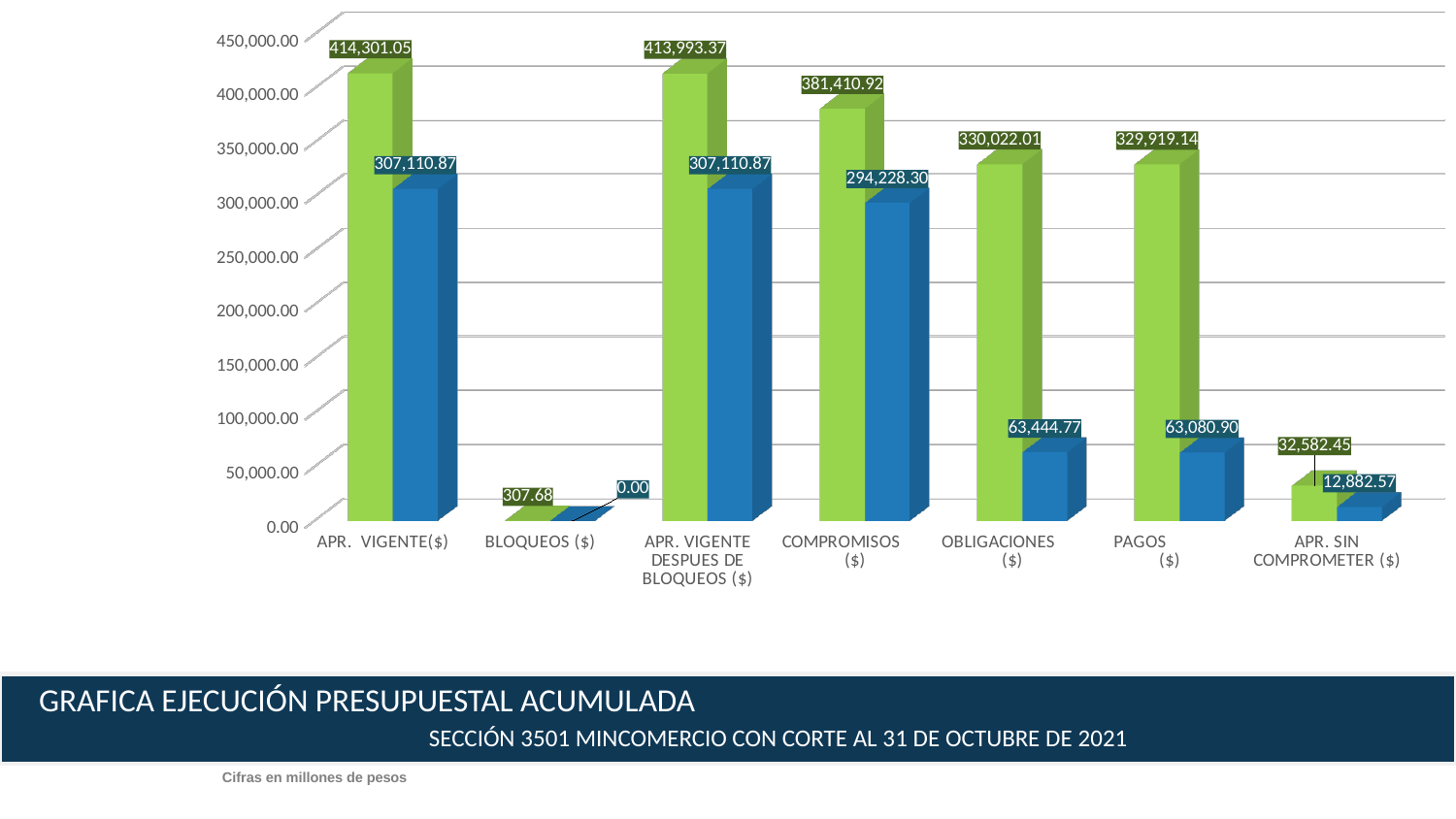
Which has the larger blue bar, COMPROMISOS ($) or OBLIGACIONES ($)? COMPROMISOS ($) What is the value of the green bar for APR. SIN COMPROMETER ($)? 32,582.45 What is the title of the chart shown on the slide? GRAFICA EJECUCIÓN PRESUPUESTAL ACUMULADA What kind of chart is shown on the slide? Bar chart What is the value of the blue bar for OBLIGACIONES ($)? 63,444.77 What is the difference between the green bar and the blue bar for PAGOS ($)? 266,838.24 What is the value of the blue bar for BLOQUEOS ($)? 0.00 What is the difference between the green bar for APR. VIGENTE($) and the green bar for APR. VIGENTE DESPUES DE BLOQUEOS ($)? 307.68 Which category has the highest green bar? APR. VIGENTE($) Which category has the lowest blue bar? BLOQUEOS ($) How many categories are shown on the x axis? 7 What is the value of the green bar for COMPROMISOS ($)? 381,410.92